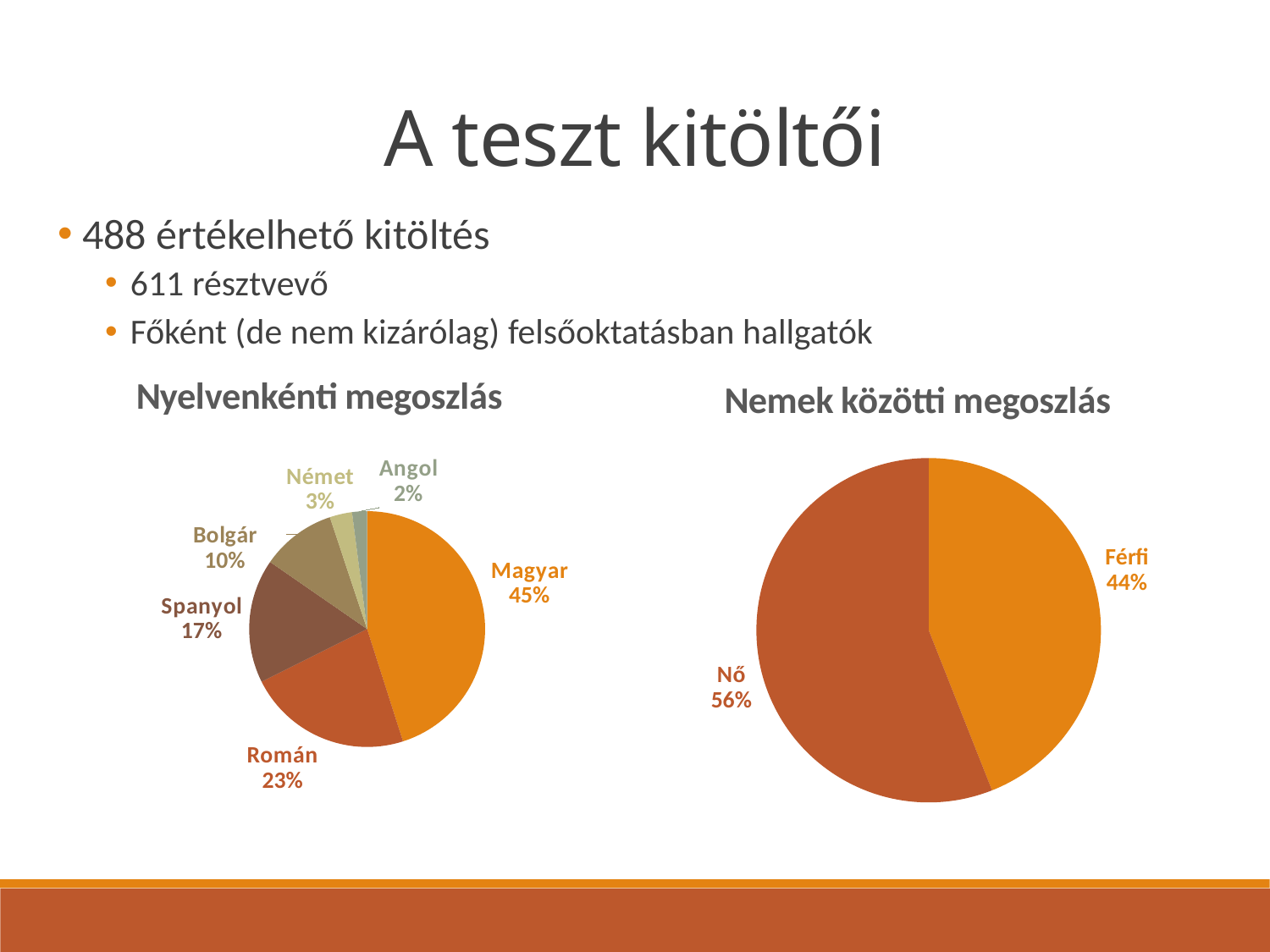
How many categories are shown in the 'Nyelvenkénti megoszlás' chart? 6 In the 'Nyelvenkénti megoszlás' chart, what is the value for Román? 23% In the 'Nyelvenkénti megoszlás' chart, what share does Magyar have? 45% In the 'Nyelvenkénti megoszlás' chart, which language has the largest slice? Magyar In the 'Nyelvenkénti megoszlás' chart, which is larger, Román or Spanyol? Román In the 'Nemek közötti megoszlás' chart, what is the difference between the Nő and Férfi shares? 12% In the 'Nemek közötti megoszlás' chart, which category is larger, Férfi or Nő? Nő In the 'Nyelvenkénti megoszlás' chart, which language has the smallest slice? Angol What kind of chart is 'Nemek közötti megoszlás'? Pie chart What is the title of the chart on the left side of the slide? Nyelvenkénti megoszlás In the 'Nemek közötti megoszlás' chart, what share does Nő have? 56% In the 'Nyelvenkénti megoszlás' chart, what is the difference between the Spanyol and Bolgár shares? 7%